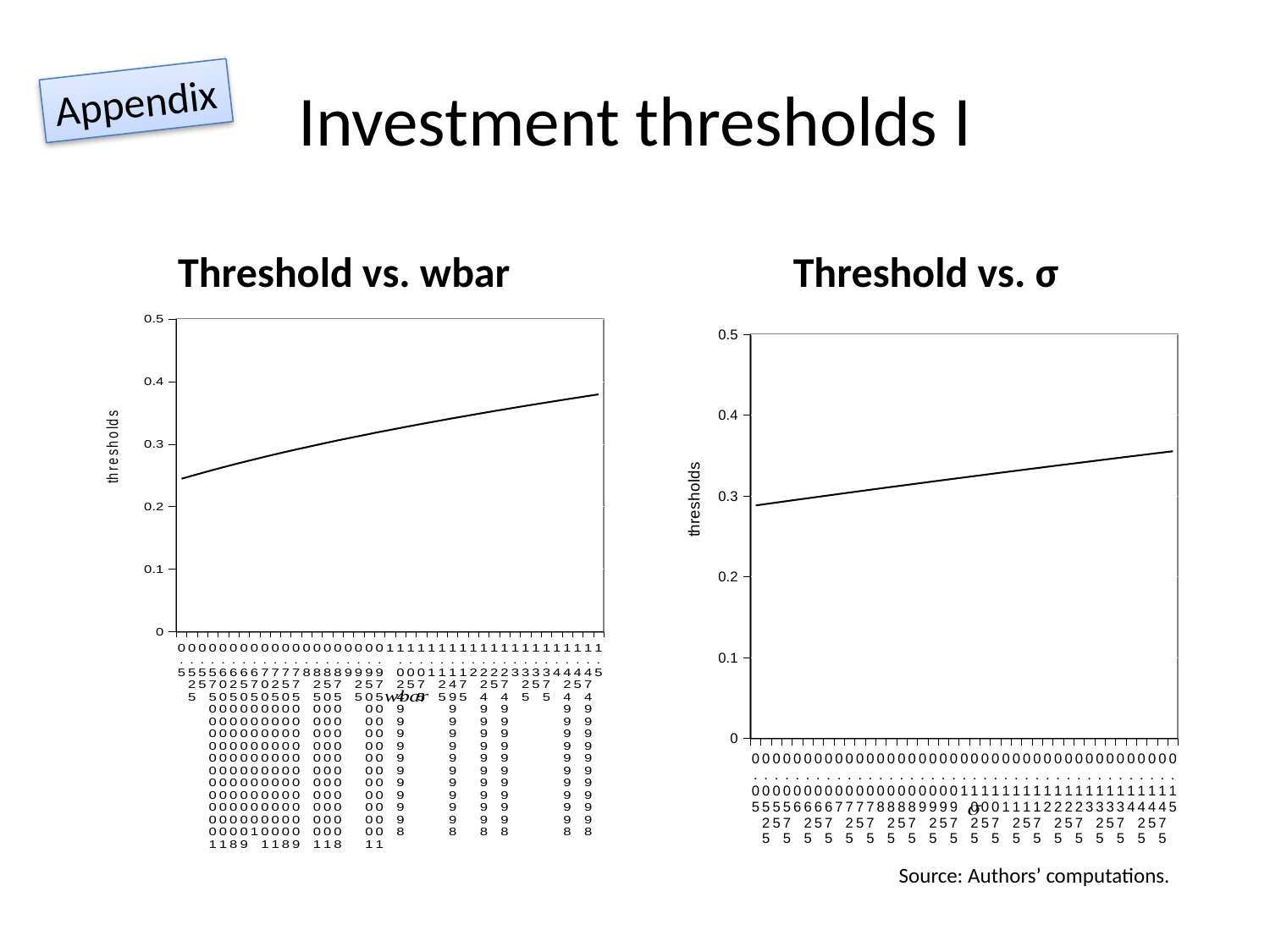
What kind of chart is the "Threshold vs. wbar" chart? line chart In the "Threshold vs. σ" chart, is the threshold value at the right end of the line greater or less than 0.3? greater In the "Threshold vs. σ" chart, do the threshold values rise or fall along the x axis? rise What is the label on the vertical axis of the "Threshold vs. σ" chart? thresholds In the "Threshold vs. wbar" chart, do the threshold values rise or fall as wbar increases along the x axis? rise What is the title of the chart on the left side of the slide? Threshold vs. wbar In the "Threshold vs. wbar" chart, is the threshold value at the right end of the line greater or less than 0.3? greater What kind of chart is the "Threshold vs. σ" chart? line chart In the "Threshold vs. wbar" chart, is the threshold value at the left end of the line greater or less than 0.3? less